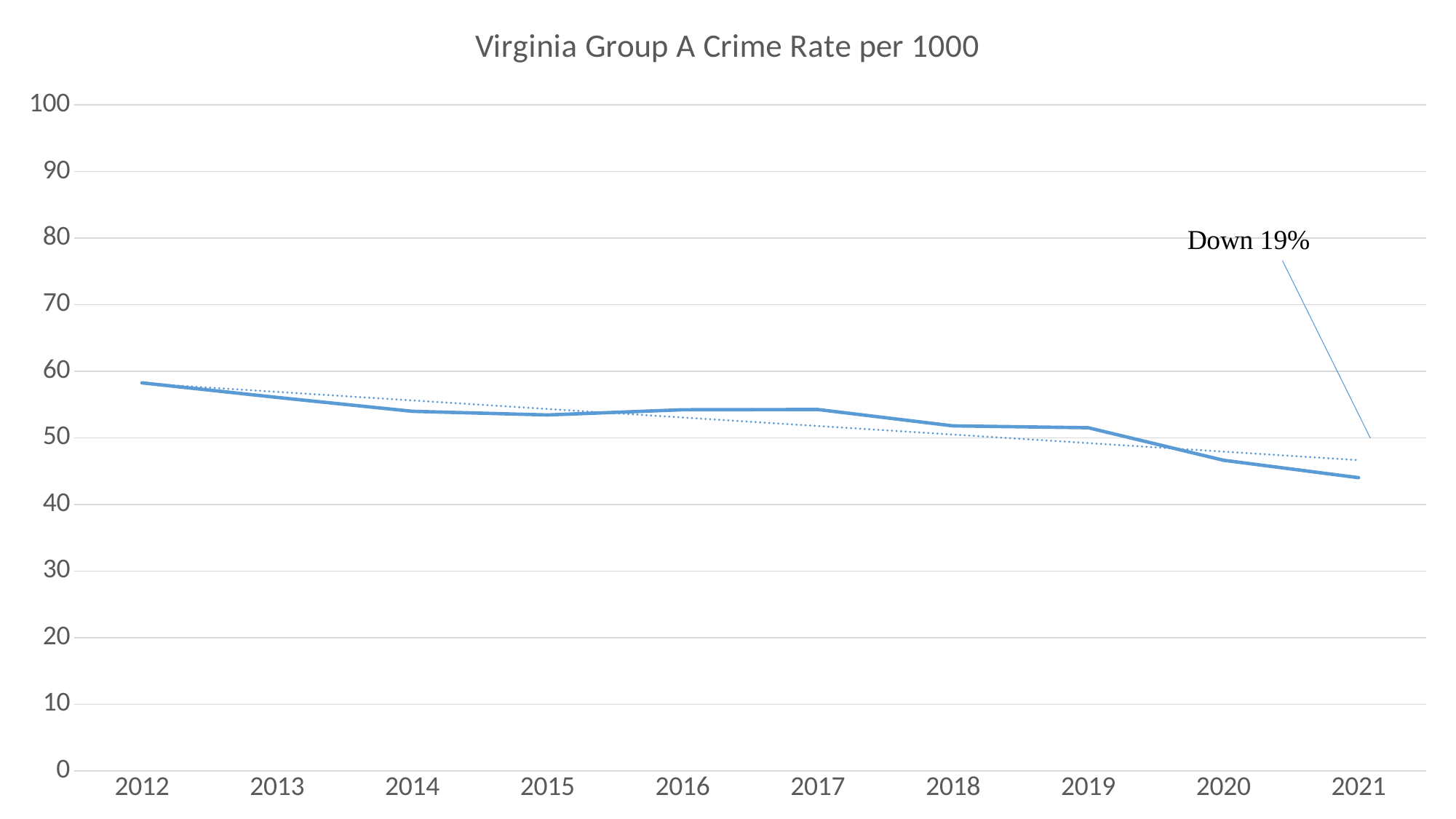
Is the value for 2020 greater or less than 50? less What is the title of the chart? Virginia Group A Crime Rate per 1000 Is the value for 2021 greater or less than 50? less What does the annotation near the end of the line say? Down 19% Which year has the lowest crime rate? 2021 Which year has the highest crime rate? 2012 Is the value for 2012 greater or less than 50? greater Which year has the larger value, 2012 or 2021? 2012 Do the values generally rise or fall from 2012 to 2021? fall What kind of chart is shown on the slide? line chart How many years are plotted along the x axis? 10